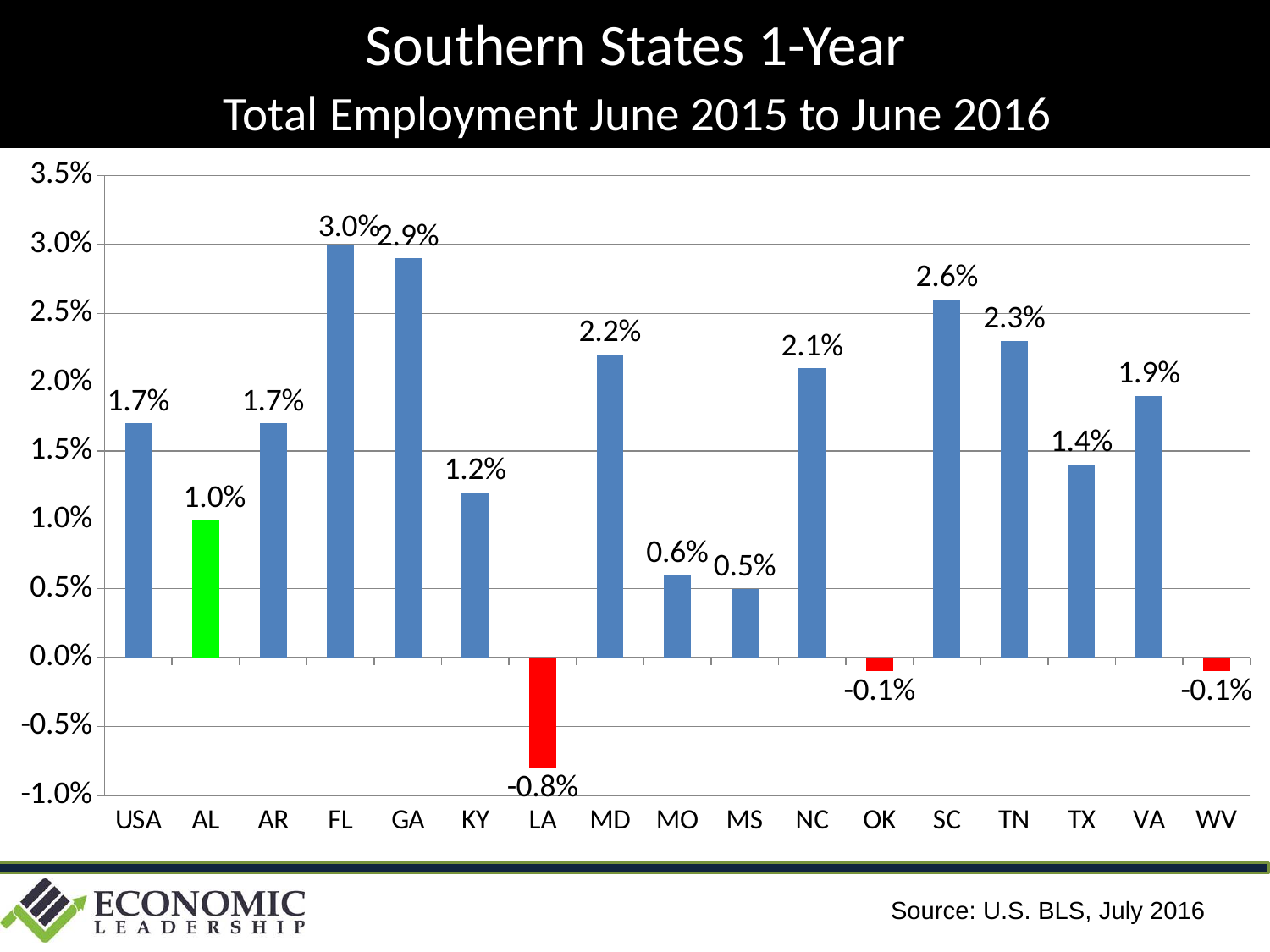
How many categories are shown on the x axis? 17 What is the difference between the values for FL and AL? 2.0% What is the value for SC? 2.6% What is the value for LA? -0.8% How many states have a negative value? 3 Which is larger, the value for NC or the value for TN? TN Which bar is coloured green? AL What kind of chart is this? Bar chart Which state has the highest value? FL Which state has the lowest value? LA What is the value for AL? 1.0% Is the value for MD greater or less than 2.0%? greater